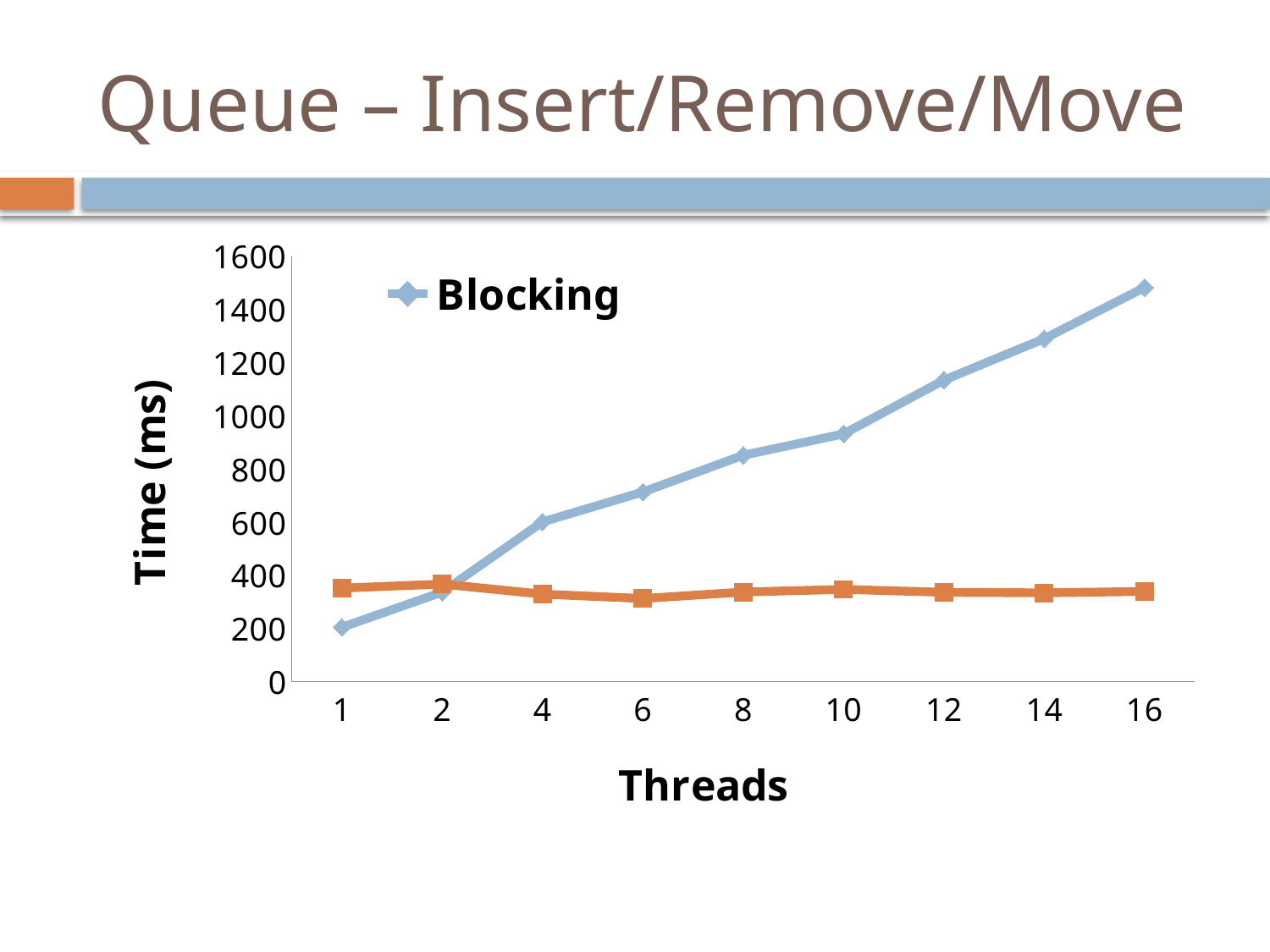
At 16 threads, which series has the larger value: Blocking or the orange square series? Blocking Is the Blocking value at 10 threads greater or less than 1000? less Is the Blocking value at 1 thread greater or less than 400? less Does the Blocking series rise or fall as the number of threads increases? rises How many series does the legend list? 1 Is the Blocking value at 4 threads greater or less than 400? greater What kind of chart is shown on the slide? line chart How many thread counts are plotted along the x axis? 9 At which number of threads is the Blocking series highest? 16 At which number of threads is the Blocking series lowest? 1 What is the label of the y axis? Time (ms)